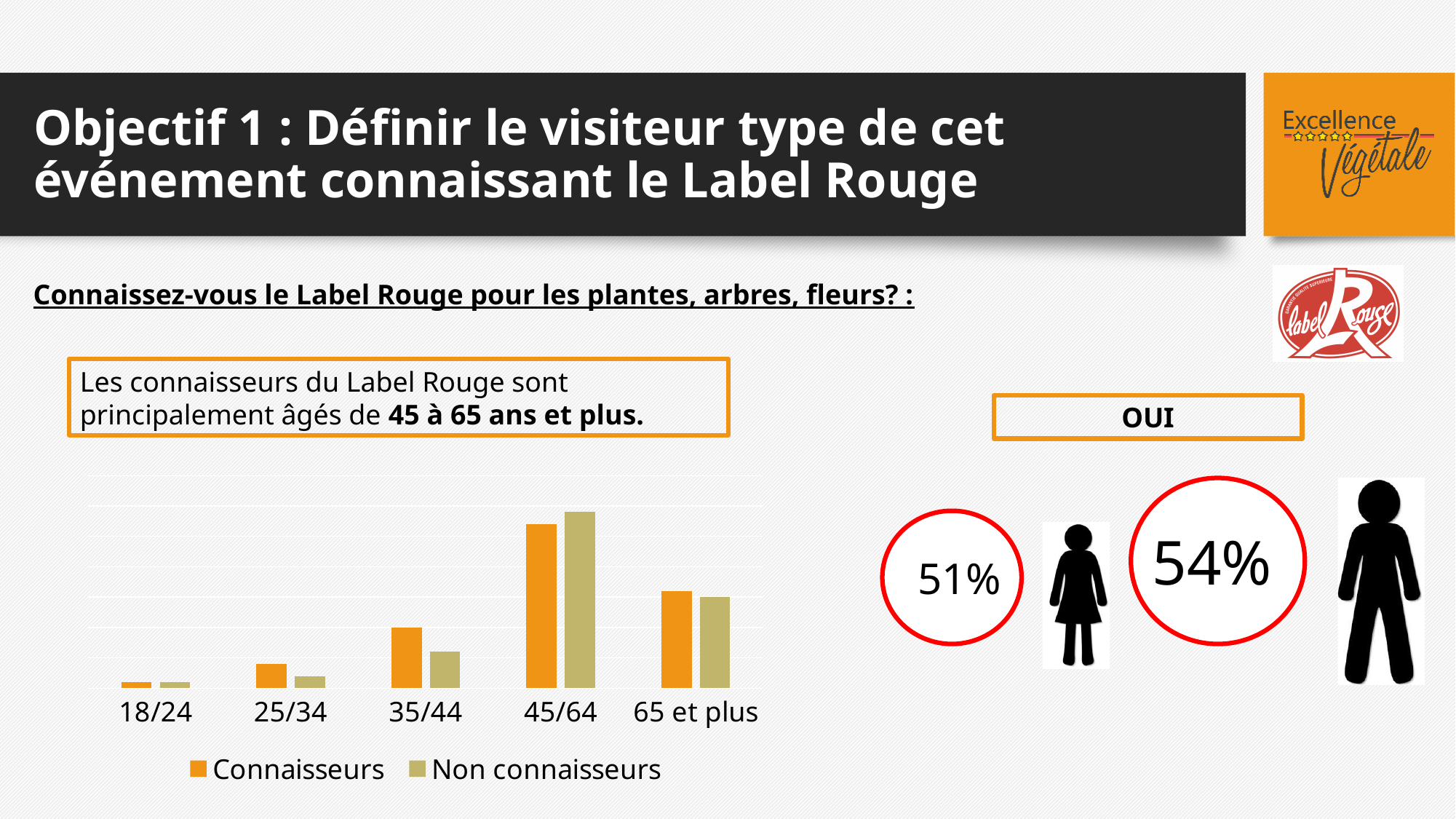
Which age category has the lowest value for the Connaisseurs series? 18/24 For the 35/44 age category, which series has the larger value, Connaisseurs or Non connaisseurs? Connaisseurs How many series does the legend of the bar chart list? 2 Do the Connaisseurs values rise or fall from 18/24 to 45/64? Rise What kind of chart is shown on the slide? Bar chart How many age categories are shown on the x axis of the bar chart? 5 Which colour represents the Connaisseurs series in the bar chart? Orange For the 45/64 age category, which series has the larger value, Connaisseurs or Non connaisseurs? Non connaisseurs Which age category has the highest value for the Connaisseurs series? 45/64 Which age category has the highest value for the Non connaisseurs series? 45/64 What are the two series names listed in the legend of the bar chart? Connaisseurs and Non connaisseurs Which age category has the lowest value for the Non connaisseurs series? 18/24